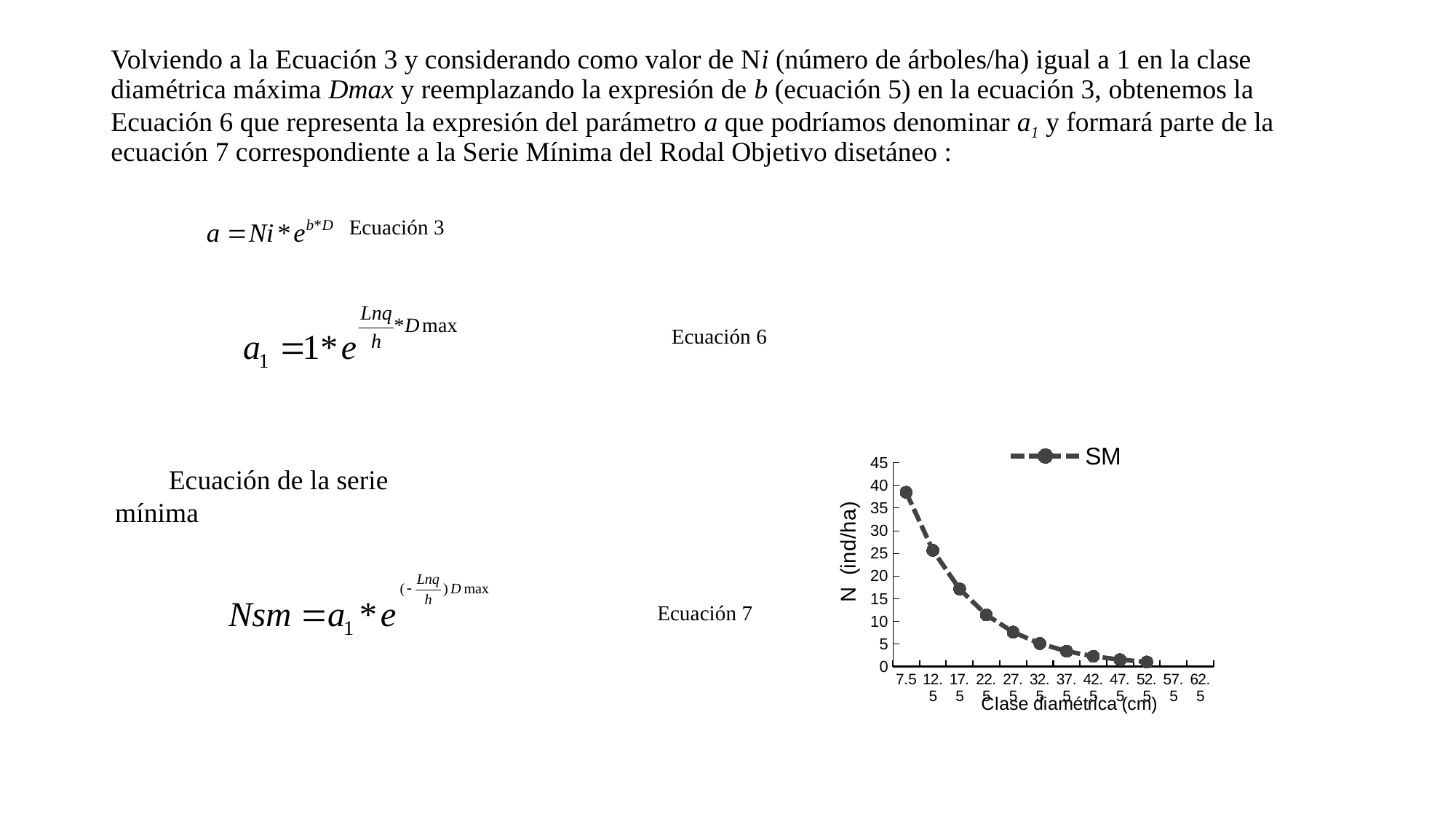
Do the SM values rise or fall as the diameter class increases along the x axis? fall Is the SM value for diameter class 12.5 greater or less than 20? greater How many series does the chart legend list? 1 Which diameter class has the highest SM value? 7.5 Which has a larger SM value, diameter class 12.5 or diameter class 22.5? 12.5 Is the SM value for diameter class 7.5 greater or less than 35? greater Is the SM value for diameter class 17.5 greater or less than 20? less What is the label of the y axis of the chart? N (ind/ha) What kind of chart is shown on the slide? line chart What is the name of the series shown in the chart legend? SM